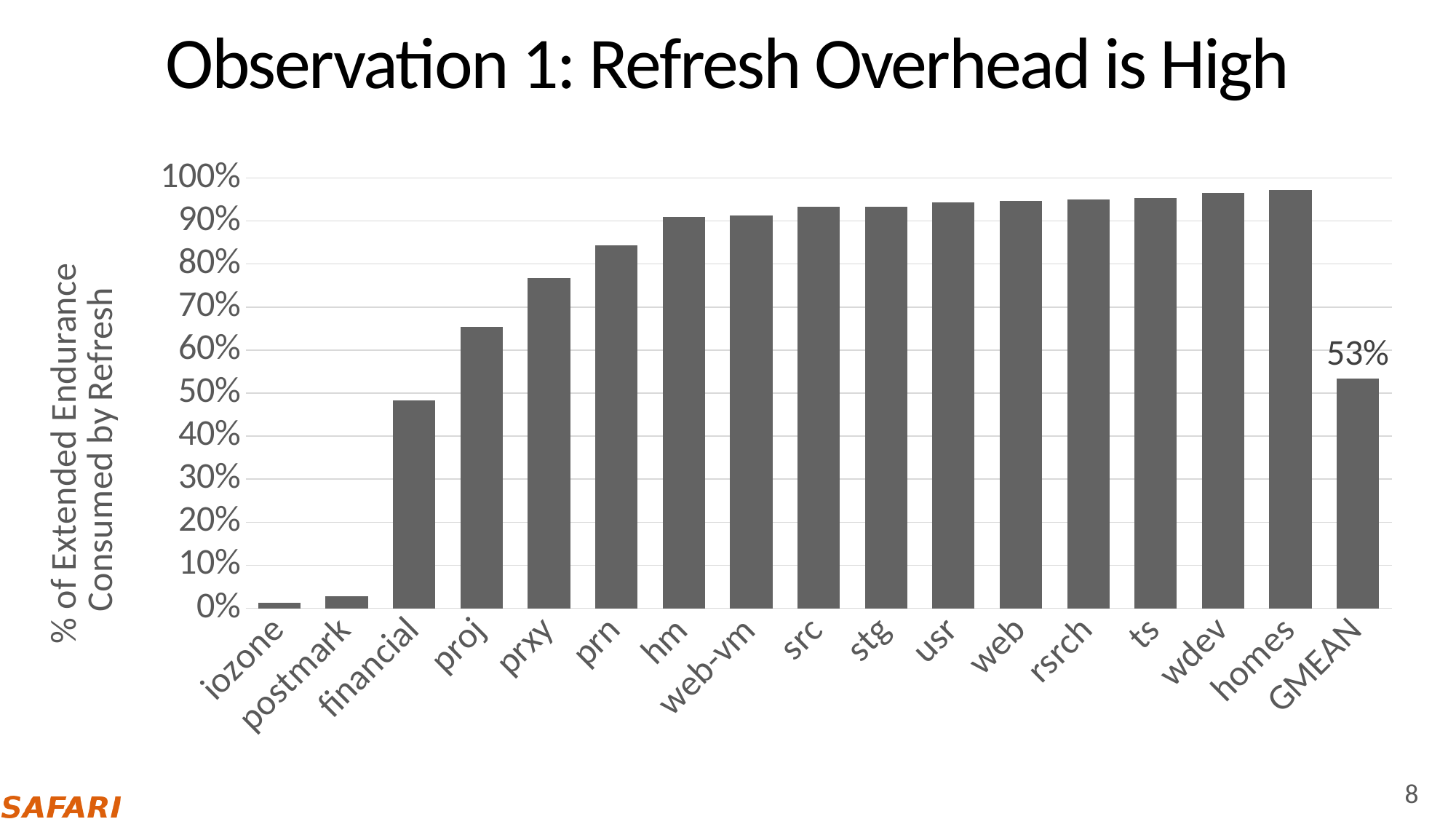
Which category has the lowest bar? iozone Is the value for prn greater or less than 80%? greater Is the value for iozone greater or less than 10%? less Which is larger, the value for financial or the value for proj? proj What value is printed for GMEAN? 53% How many bars are shown in the chart? 17 Is the value for proj greater or less than 60%? greater What is the label of the y axis? % of Extended Endurance Consumed by Refresh What kind of chart is shown on the slide? bar chart Which is larger, the value for prxy or the value for prn? prn